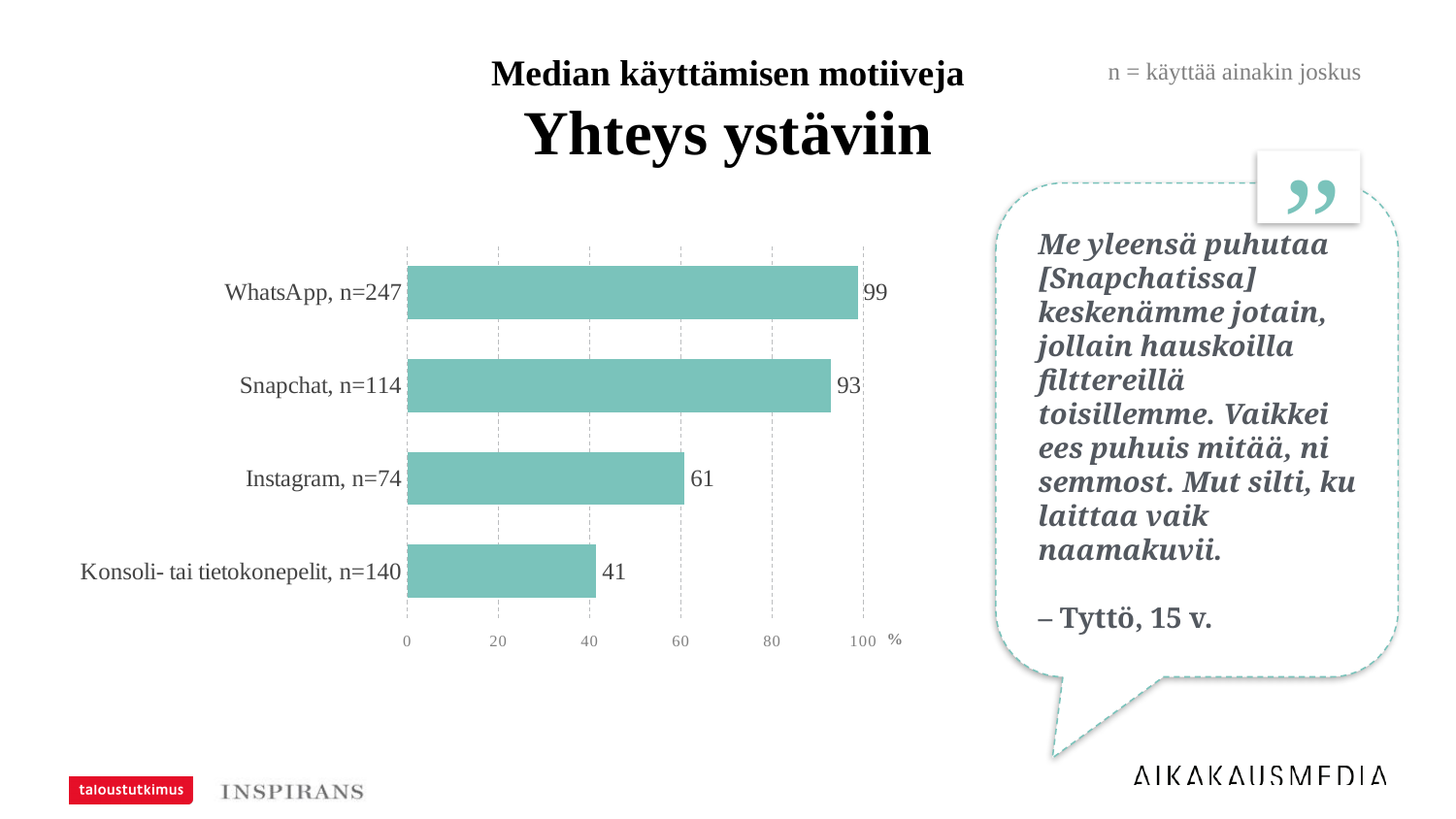
Which is larger, the value for Instagram, n=74 or the value for Konsoli- tai tietokonepelit, n=140? Instagram, n=74 Which category has the highest value? WhatsApp, n=247 What kind of chart is shown on the slide? Bar chart What is the value for Snapchat, n=114? 93 Which category has the lowest value? Konsoli- tai tietokonepelit, n=140 What is the value for Konsoli- tai tietokonepelit, n=140? 41 What is the difference between the values for Instagram, n=74 and Konsoli- tai tietokonepelit, n=140? 20 What is the value for Instagram, n=74? 61 What is the value for WhatsApp, n=247? 99 What is the difference between the values for WhatsApp, n=247 and Snapchat, n=114? 6 How many categories are shown in the chart? 4 Is the value for Instagram, n=74 greater or less than 80? less